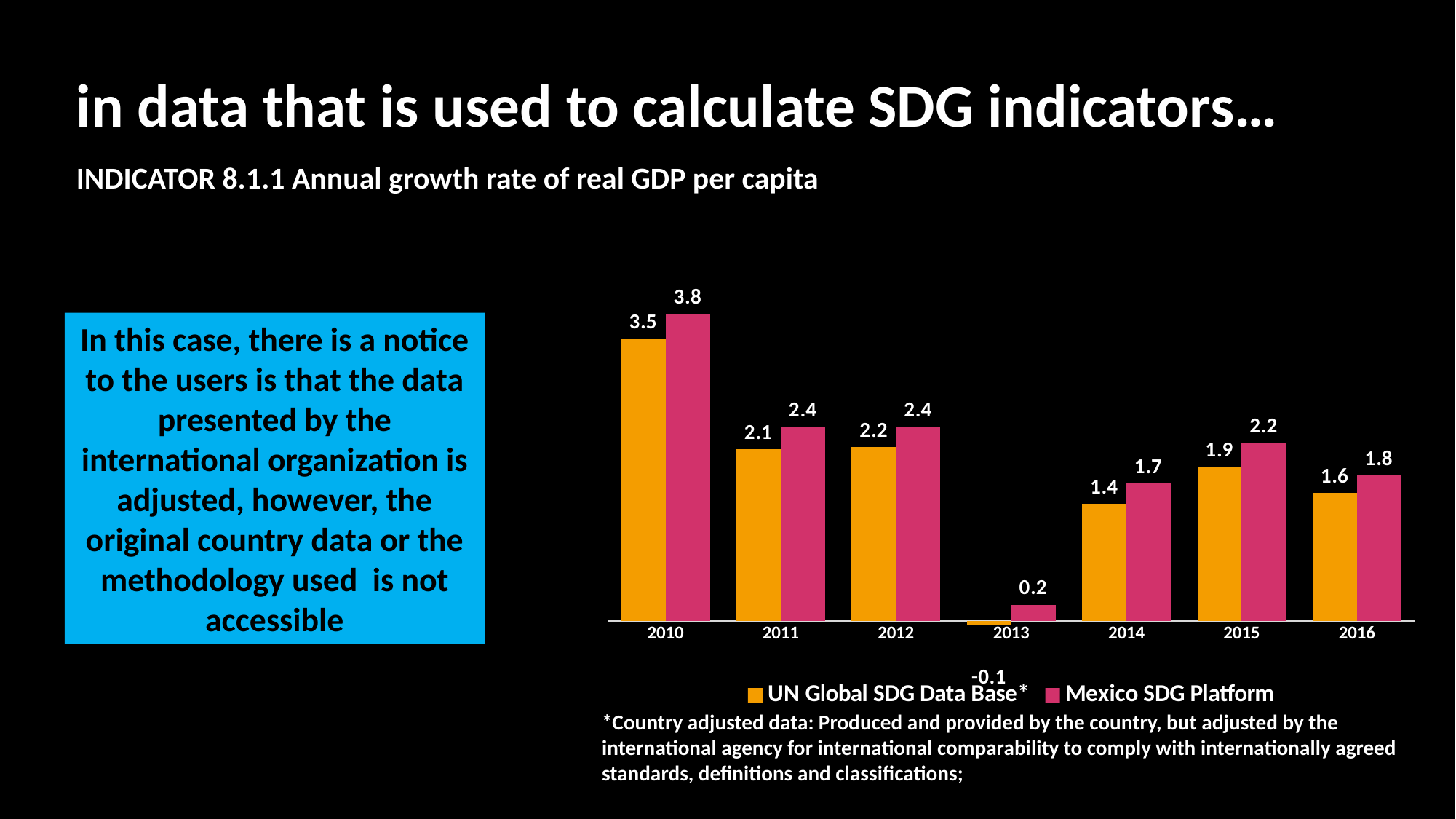
What kind of chart is shown on the slide? Bar chart How many years are shown on the x axis? 7 What is the difference between the Mexico SDG Platform and UN Global SDG Data Base values in 2014? 0.3 How many series does the legend list? 2 What is the value for the UN Global SDG Data Base series in 2010? 3.5 Which indicator does the chart show? Indicator 8.1.1 Annual growth rate of real GDP per capita What is the value for the UN Global SDG Data Base series in 2013? -0.1 Which year has the lowest value for the UN Global SDG Data Base series? 2013 What is the value for the Mexico SDG Platform series in 2013? 0.2 Which year has the highest value for the Mexico SDG Platform series? 2010 What is the difference between the Mexico SDG Platform and UN Global SDG Data Base values in 2010? 0.3 Which series has the larger value in 2015, UN Global SDG Data Base or Mexico SDG Platform? Mexico SDG Platform